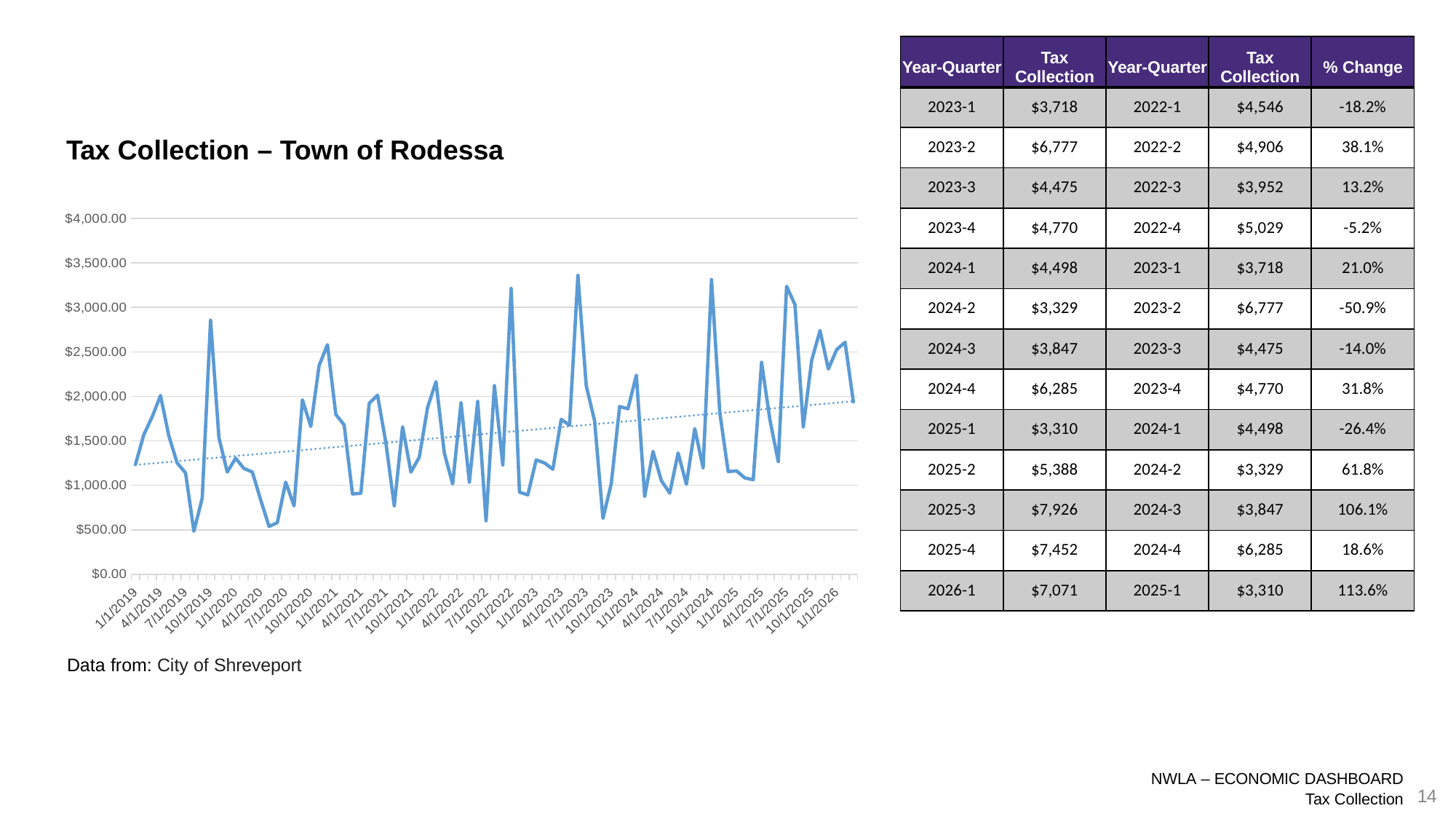
What is the title of the chart? Tax Collection – Town of Rodessa Is the value for 1/1/2021 greater or less than $2,000? less Is the value for 1/1/2019 greater or less than $1,000? greater What is the highest value shown on the chart's vertical axis? $4,000.00 What kind of chart is shown on the slide? line chart Is the value for 10/1/2024 greater or less than $3,000? greater According to the dotted trend line, do the values generally rise or fall from 2019 to 2026? rise Which is larger, the value for 7/1/2023 or the value for 10/1/2023? 7/1/2023